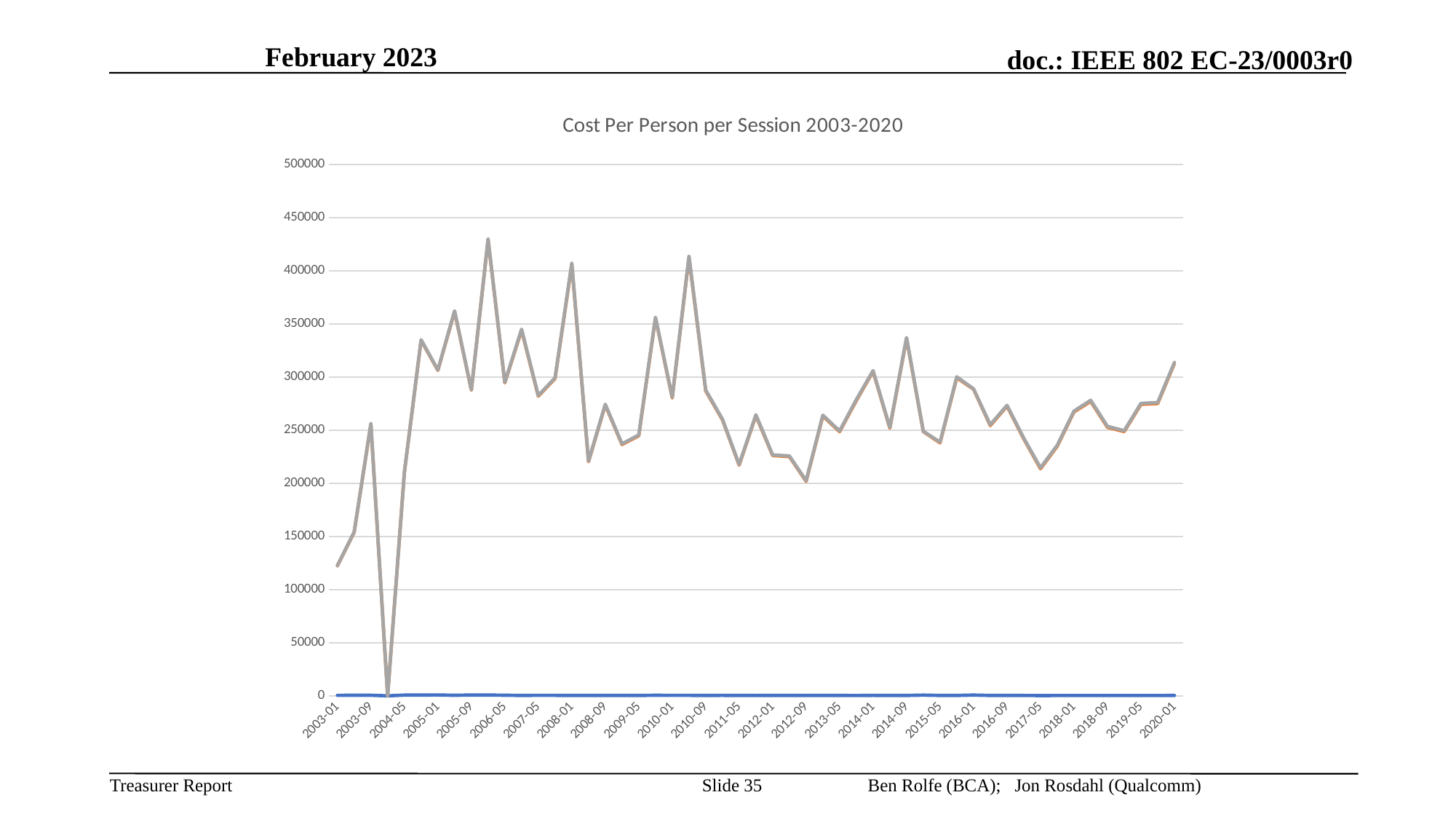
What kind of chart is shown on the slide? line chart Is the value for 2020-01 greater or less than 300000? greater Which is larger, the value for 2003-01 or the value for 2020-01? 2020-01 What is the title of the chart? Cost Per Person per Session 2003-2020 Is the value for 2003-01 greater or less than 150000? less Is the highest value on the chart greater or less than 400000? greater What is the first date label on the horizontal axis? 2003-01 Does the line rise or fall between 2003-01 and 2003-09? rise What is the last date label on the horizontal axis? 2020-01 What is the lowest value the line drops to on the chart? 0 What is the highest value shown on the vertical axis? 500000